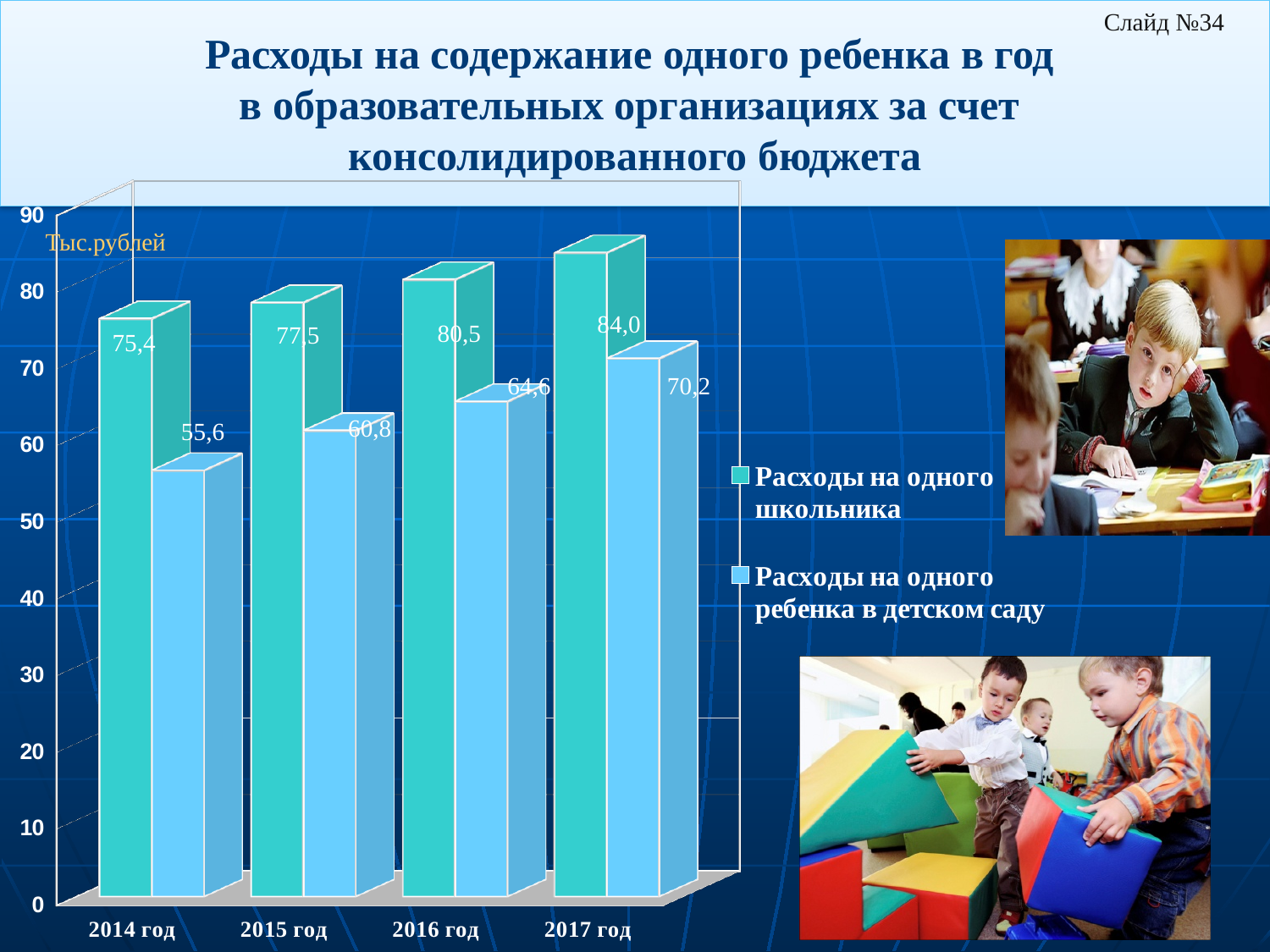
What is the value for 'Расходы на одного ребенка в детском саду' in 2017 год? 70,2 Is the value for 'Расходы на одного школьника' in 2017 год greater or less than 80? greater Which is larger in 2015 год: 'Расходы на одного школьника' or 'Расходы на одного ребенка в детском саду'? Расходы на одного школьника In which year is 'Расходы на одного школьника' highest? 2017 год How many years are shown on the x axis of the chart? 4 How many series does the chart legend list? 2 In which year is 'Расходы на одного ребенка в детском саду' lowest? 2014 год What kind of chart is shown on the slide? bar chart What is the difference between 'Расходы на одного школьника' and 'Расходы на одного ребенка в детском саду' in 2016 год? 15,9 What is the value for 'Расходы на одного ребенка в детском саду' in 2015 год? 60,8 What is the value for 'Расходы на одного школьника' in 2014 год? 75,4 Do the values for 'Расходы на одного ребенка в детском саду' rise or fall from 2014 год to 2017 год? rise